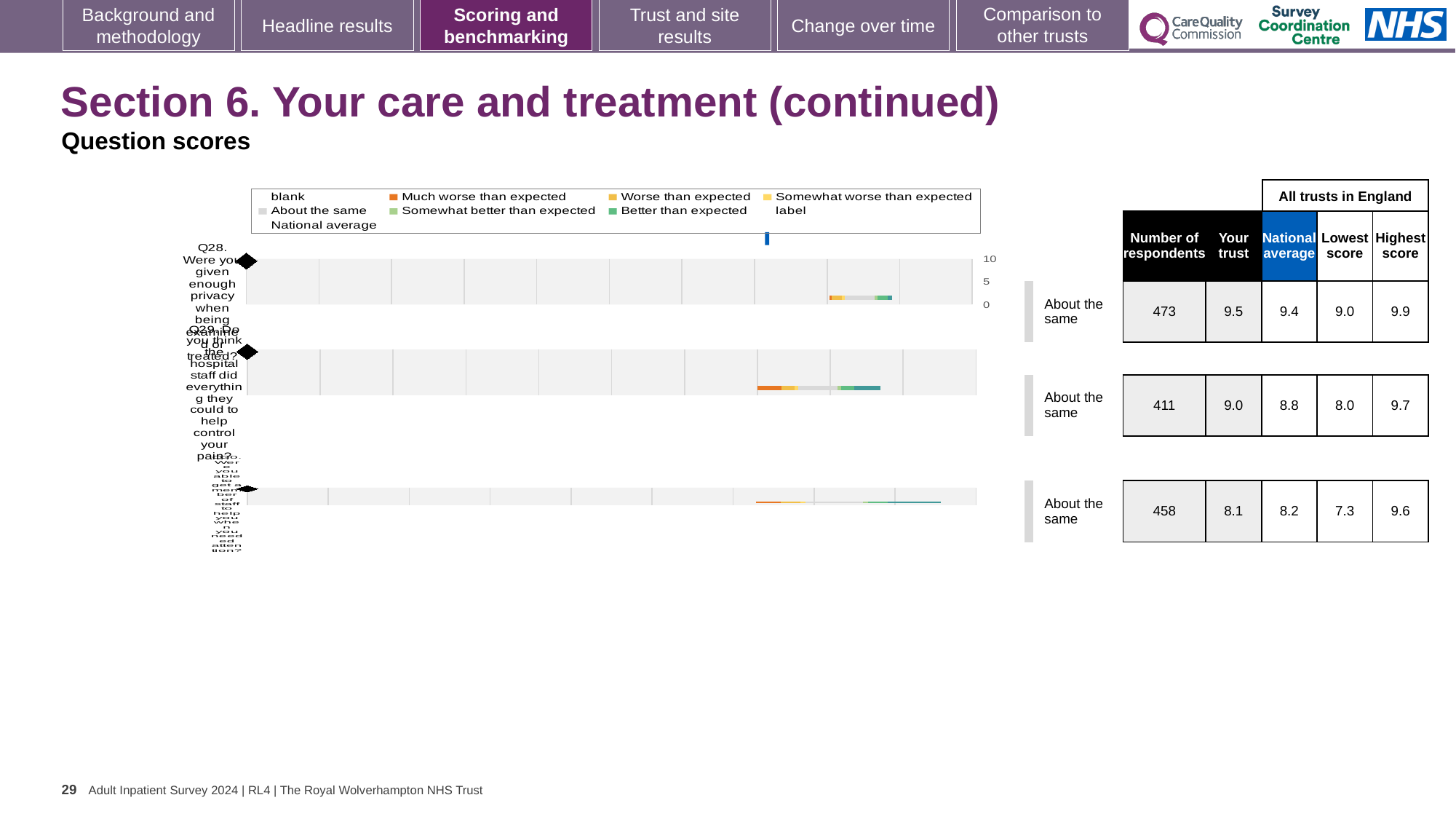
How many questions (Q28, Q29, Q30) are plotted on this slide? 3 For Q30, is the 'Your trust' score or the national average score larger? National average For Q28 (privacy when being examined or treated), what is the 'Your trust' score shown in the table? 9.5 What kind of chart is used to show the question scores on this slide? bar chart Which question has the lowest 'Your trust' score? Q30 Which question has the highest number of respondents? Q28 For Q29, what is the difference between the highest score (9.7) and the lowest score (8.0) across all trusts in England? 1.7 For Q28, what is the difference between the 'Your trust' score and the national average? 0.1 For Q30, how many respondents are listed? 458 What benchmark category is shown for Q29? About the same How many entries does the chart legend list? 9 For Q29 (staff did everything to help control your pain), what is the national average score? 8.8